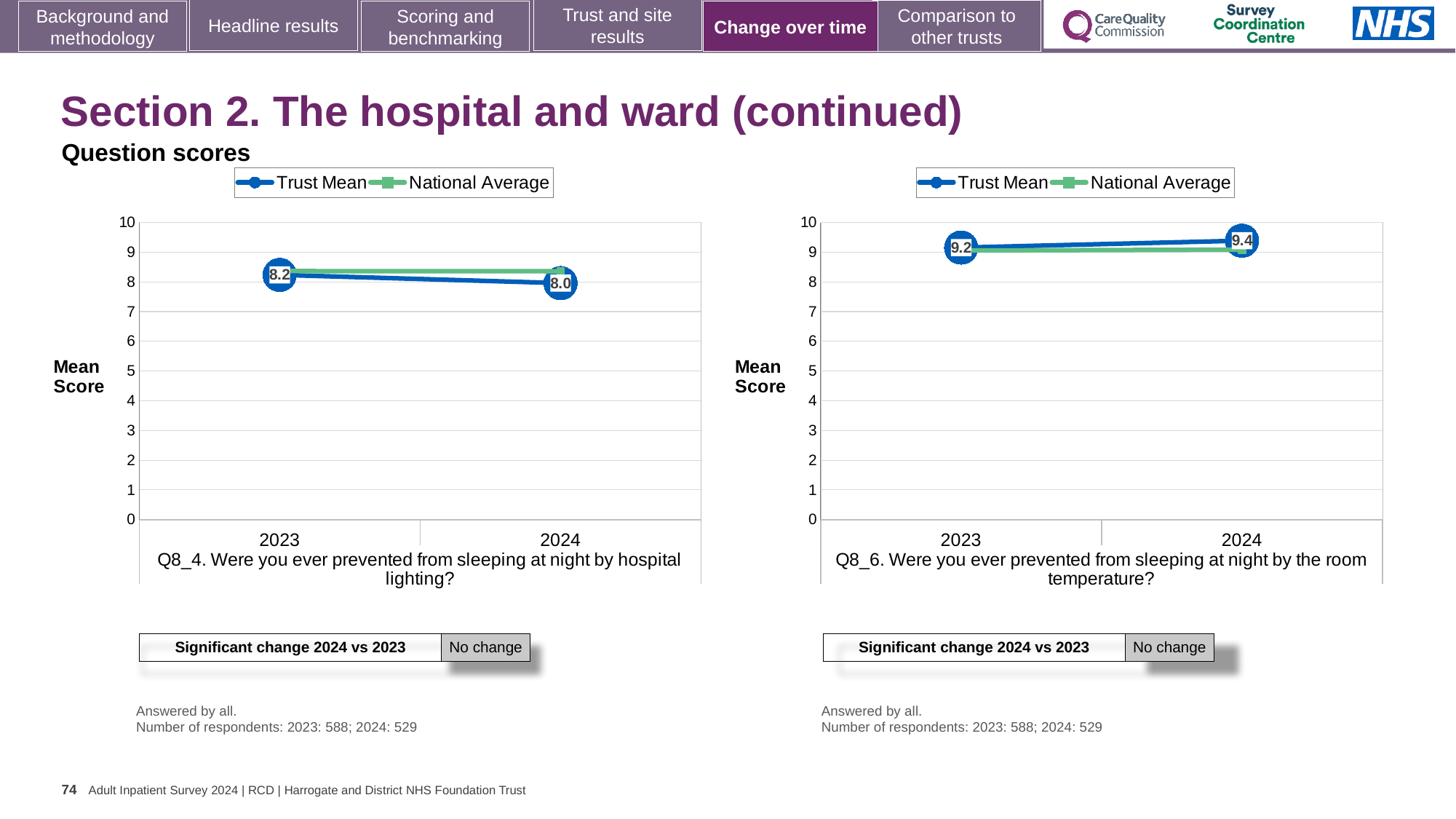
In the Q8_4 chart (left), what is the Trust Mean score for 2023? 8.2 In the Q8_6 chart (right), what is the Trust Mean score for 2023? 9.2 In the Q8_6 chart (right), is the Trust Mean for 2024 greater or less than 9? greater In the Q8_4 chart (left), does the Trust Mean rise or fall from 2023 to 2024? fall What kind of chart is used on this slide? line chart In the Q8_4 chart (left), by how much did the Trust Mean change from 2023 to 2024? 0.2 What does the 'Significant change 2024 vs 2023' box below the Q8_6 chart (right) say? No change In the Q8_6 chart (right), what is the Trust Mean score for 2024? 9.4 In the Q8_6 chart (right), what is the difference between the Trust Mean for 2024 and 2023? 0.2 In the Q8_4 chart (left), what is the Trust Mean score for 2024? 8.0 How many series does the legend of the Q8_4 chart (left) list? 2 In the Q8_6 chart (right), does the Trust Mean rise or fall from 2023 to 2024? rise